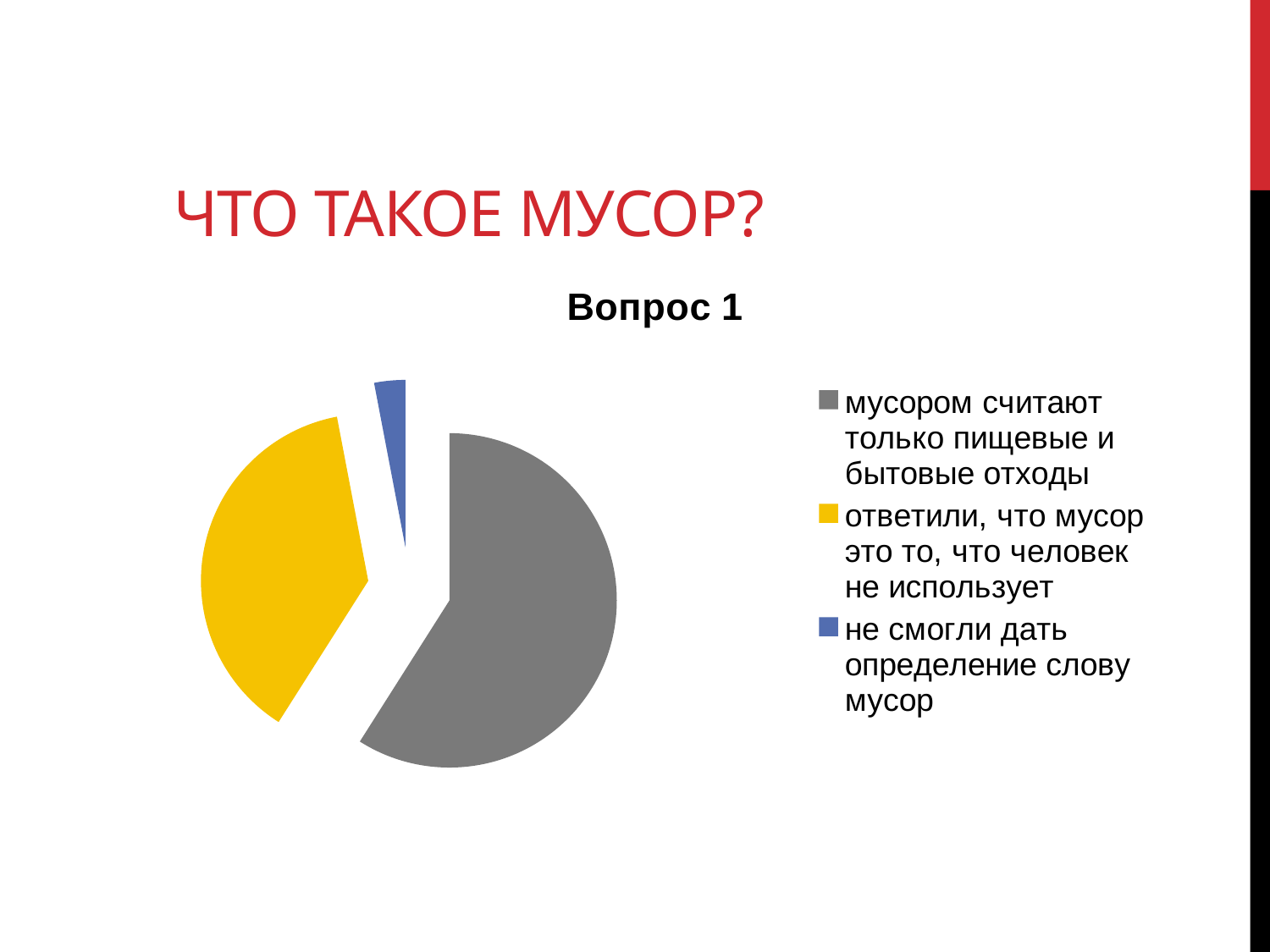
Which slice is larger: 'мусором считают только пищевые и бытовые отходы' or 'ответили, что мусор это то, что человек не использует'? мусором считают только пищевые и бытовые отходы Which category has the largest slice of the pie? мусором считают только пищевые и бытовые отходы How many entries does the legend list? 3 What kind of chart is shown on the slide? pie chart Which slice is larger: 'ответили, что мусор это то, что человек не использует' or 'не смогли дать определение слову мусор'? ответили, что мусор это то, что человек не использует What colour is the slice for 'не смогли дать определение слову мусор'? blue What is the title of the chart? Вопрос 1 Which category has the smallest slice of the pie? не смогли дать определение слову мусор How many slices does the pie chart have? 3